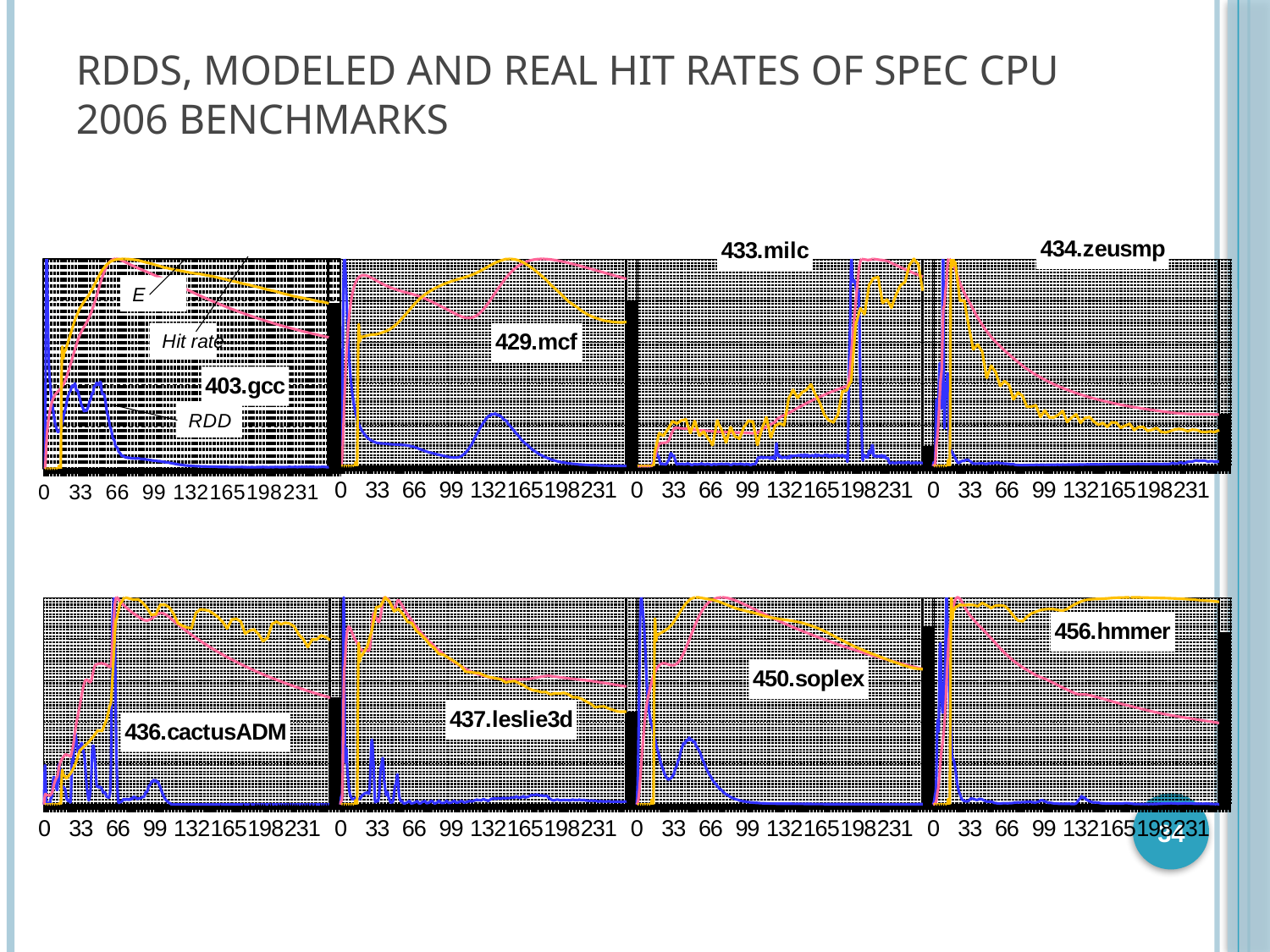
Which benchmark chart is in the bottom-left position of the slide? 436.cactusADM In the 434.zeusmp chart, does the E line rise or fall along the x axis after its initial peak? fall What are the three series labeled in the 403.gcc chart? E, Hit rate, RDD How many benchmark charts are shown on the slide? 8 How many lines (series) are labeled in the 403.gcc chart? 3 In the 433.milc chart, does the E line generally rise or fall from 0 toward 198 on the x axis? rise In the 456.hmmer chart, does the Hit rate line rise or fall along the x axis after its initial peak? fall What kind of chart is used for each benchmark on this slide? line chart Which benchmark chart is located directly below the 429.mcf chart? 437.leslie3d Which benchmark chart is in the top-right position of the slide? 434.zeusmp What is the last tick value shown on the x axis of each chart? 231 How many tick labels are shown on the x axis of the 429.mcf chart? 8